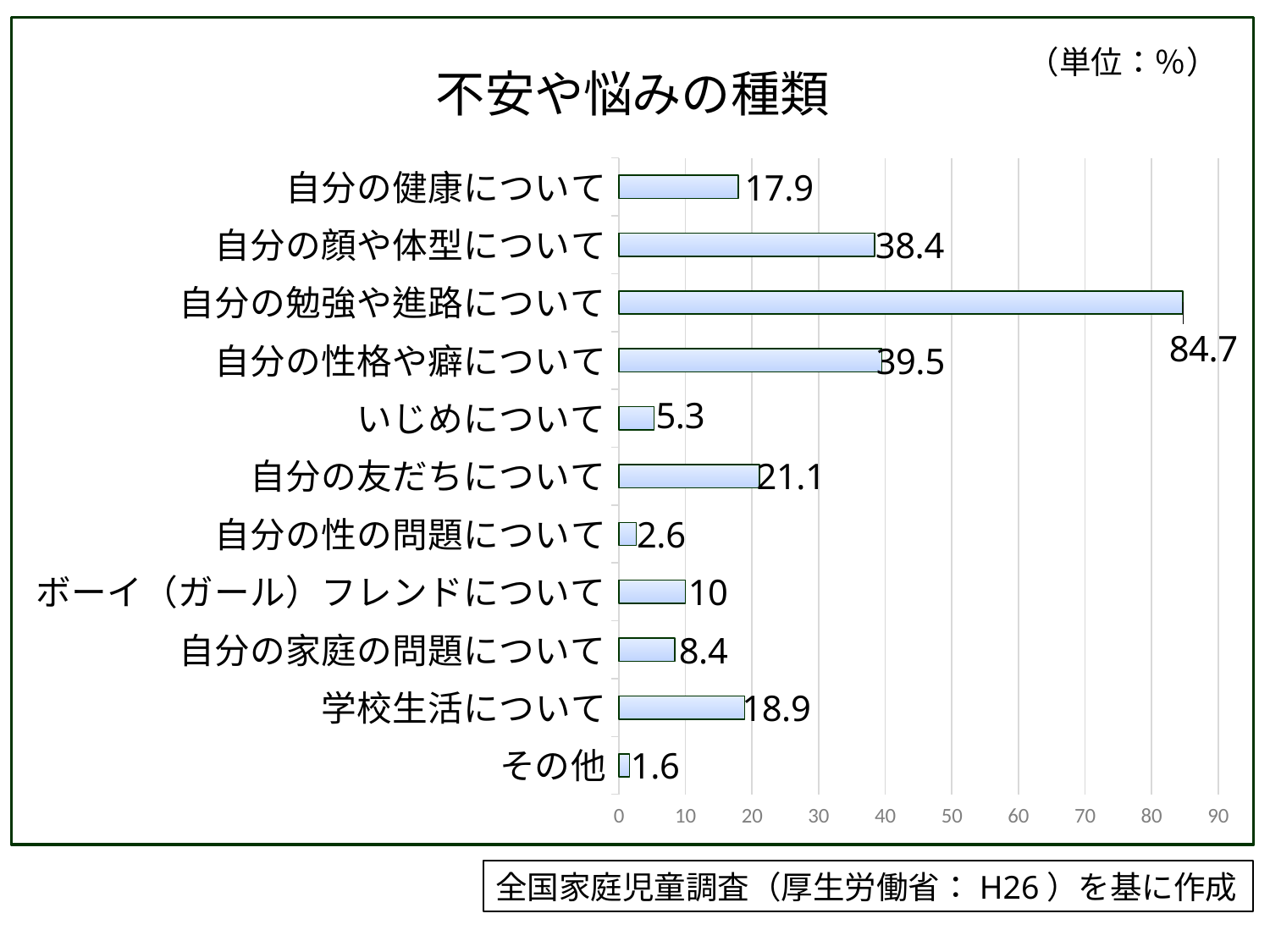
Which is larger, the value for 自分の友だちについて or the value for 学校生活について? 自分の友だちについて Which category has the lowest value? その他 What kind of chart is shown on the slide? bar chart Is the value for 自分の健康について greater or less than 20? less What is the difference between the values for 自分の性格や癖について and 自分の顔や体型について? 1.1 What is the value for 自分の勉強や進路について? 84.7 How many categories are shown in the chart? 11 What is the title of the chart? 不安や悩みの種類 What unit is indicated for the chart values? % What is the value for いじめについて? 5.3 What is the value for ボーイ（ガール）フレンドについて? 10 Which category has the highest value? 自分の勉強や進路について